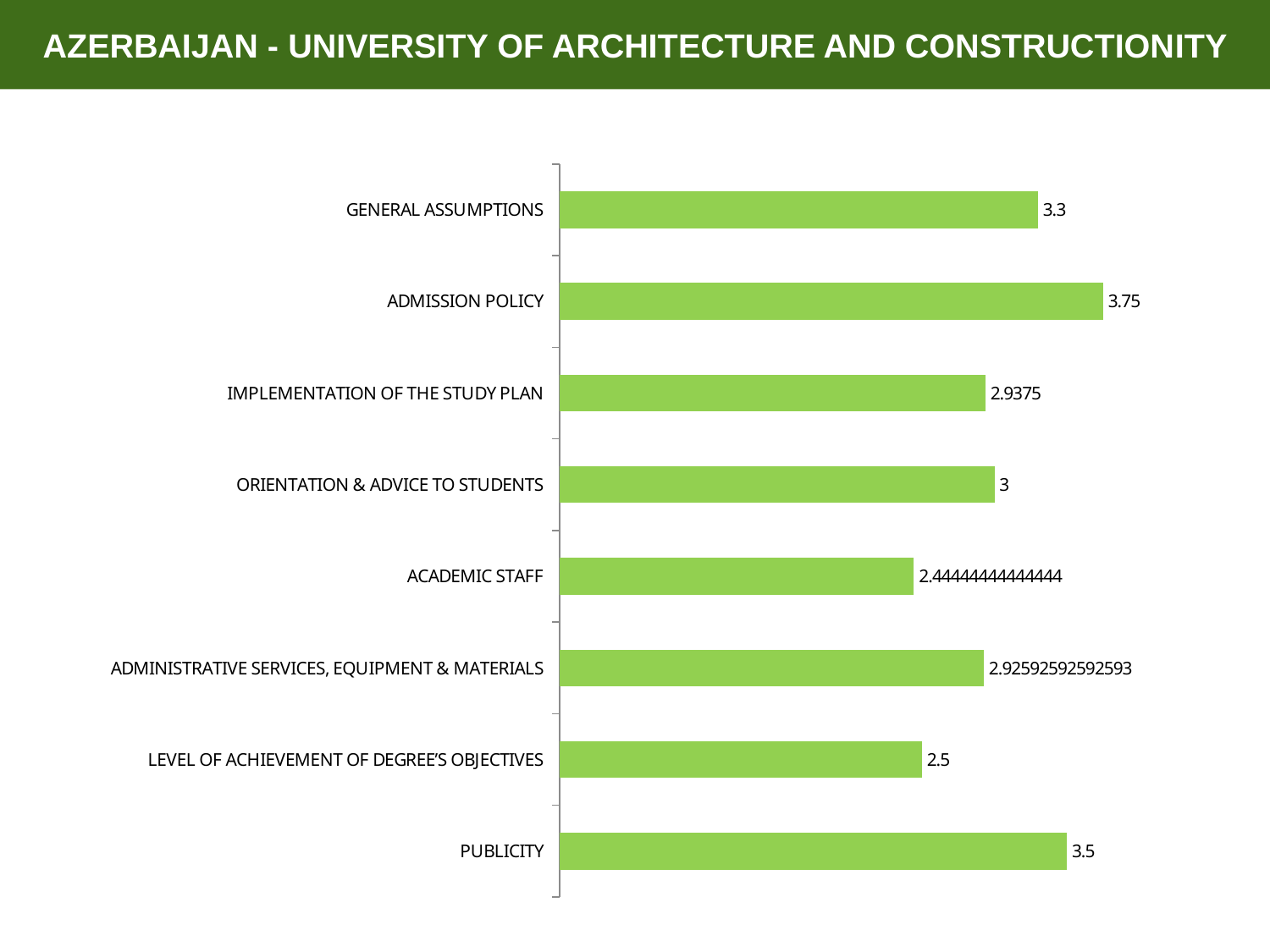
What is the value for LEVEL OF ACHIEVEMENT OF DEGREE'S OBJECTIVES? 2.5 What is the value for IMPLEMENTATION OF THE STUDY PLAN? 2.9375 What is the difference between the values for PUBLICITY and LEVEL OF ACHIEVEMENT OF DEGREE'S OBJECTIVES? 1 Which has a larger value, PUBLICITY or GENERAL ASSUMPTIONS? PUBLICITY Which category has the highest value? ADMISSION POLICY How many categories are shown in the chart? 8 What is the value for ADMISSION POLICY? 3.75 What is the difference between the values for ADMISSION POLICY and GENERAL ASSUMPTIONS? 0.45 Which category has the lowest value? ACADEMIC STAFF What kind of chart is shown on the slide? Bar chart What is the value for PUBLICITY? 3.5 What is the value for ACADEMIC STAFF? 2.4444444444444